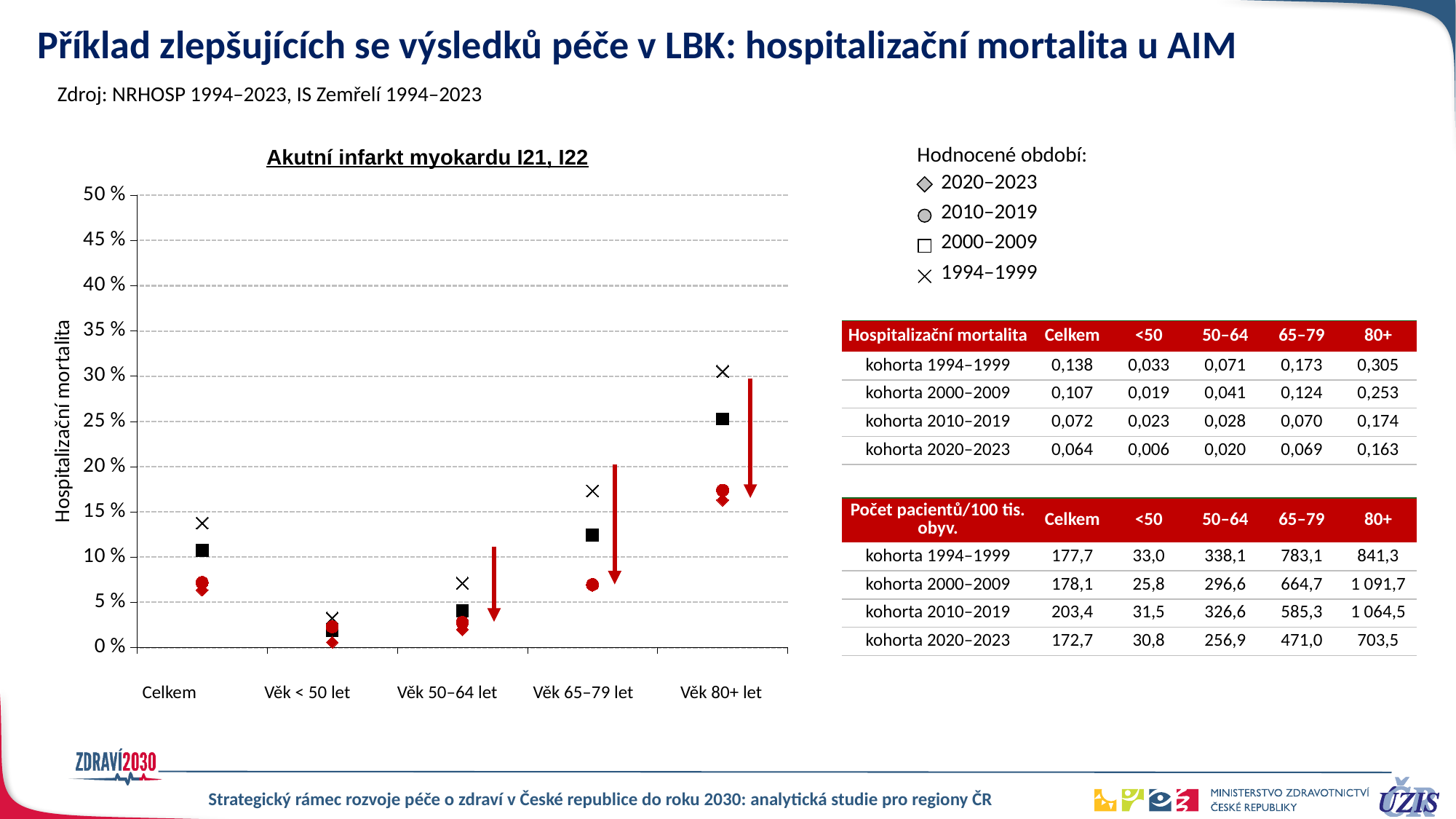
Is the 1994–1999 value for Věk < 50 let greater or less than 5 %? less Which category has the lowest hospitalization mortality for the 1994–1999 period? Věk < 50 let How many periods (series) does the legend list? 4 Is the 2010–2019 value for Věk 65–79 let greater or less than 10 %? less Moving from Věk < 50 let to Věk 80+ let, does hospitalization mortality for the 1994–1999 period rise or fall? rise What kind of chart is shown on the slide? scatter chart Is the 1994–1999 value for Věk 80+ let greater or less than 25 %? greater For Věk 80+ let, which period has the larger hospitalization mortality: 1994–1999 or 2000–2009? 1994–1999 How many categories are shown on the x axis of the chart? 5 What is the title of the chart? Akutní infarkt myokardu I21, I22 Which category has the highest hospitalization mortality for the 1994–1999 period? Věk 80+ let